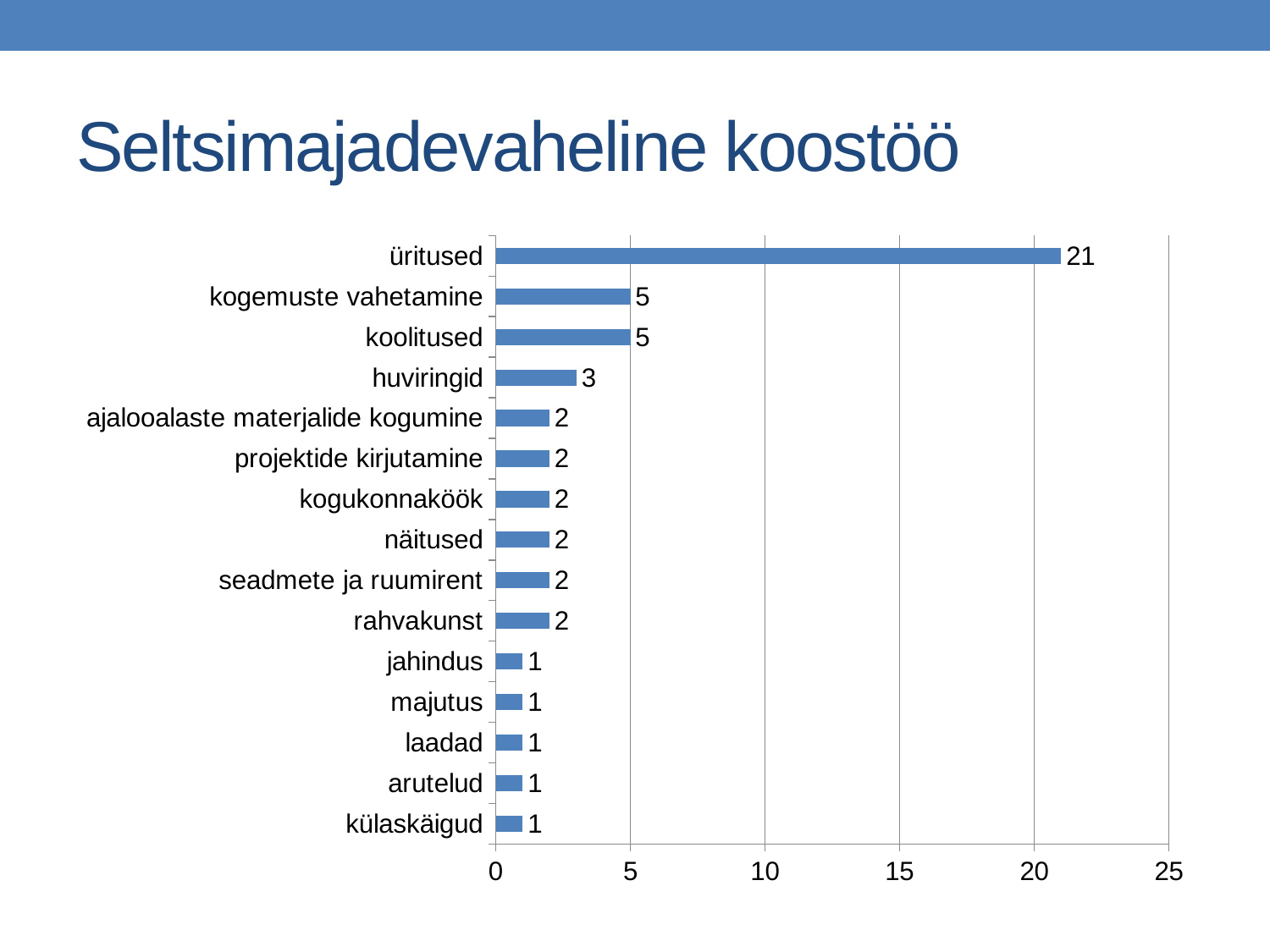
Which category has the highest value? üritused Which is larger, the value for koolitused or the value for näitused? koolitused What is the difference between the values for huviringid and rahvakunst? 1 What is the title of the slide? Seltsimajadevaheline koostöö What is the value for kogemuste vahetamine? 5 Is the value for üritused greater or less than 20? greater What is the difference between the values for üritused and koolitused? 16 What is the value for külaskäigud? 1 What is the value for huviringid? 3 What is the value for üritused? 21 What kind of chart is shown on the slide? bar chart How many categories are shown in the chart? 15